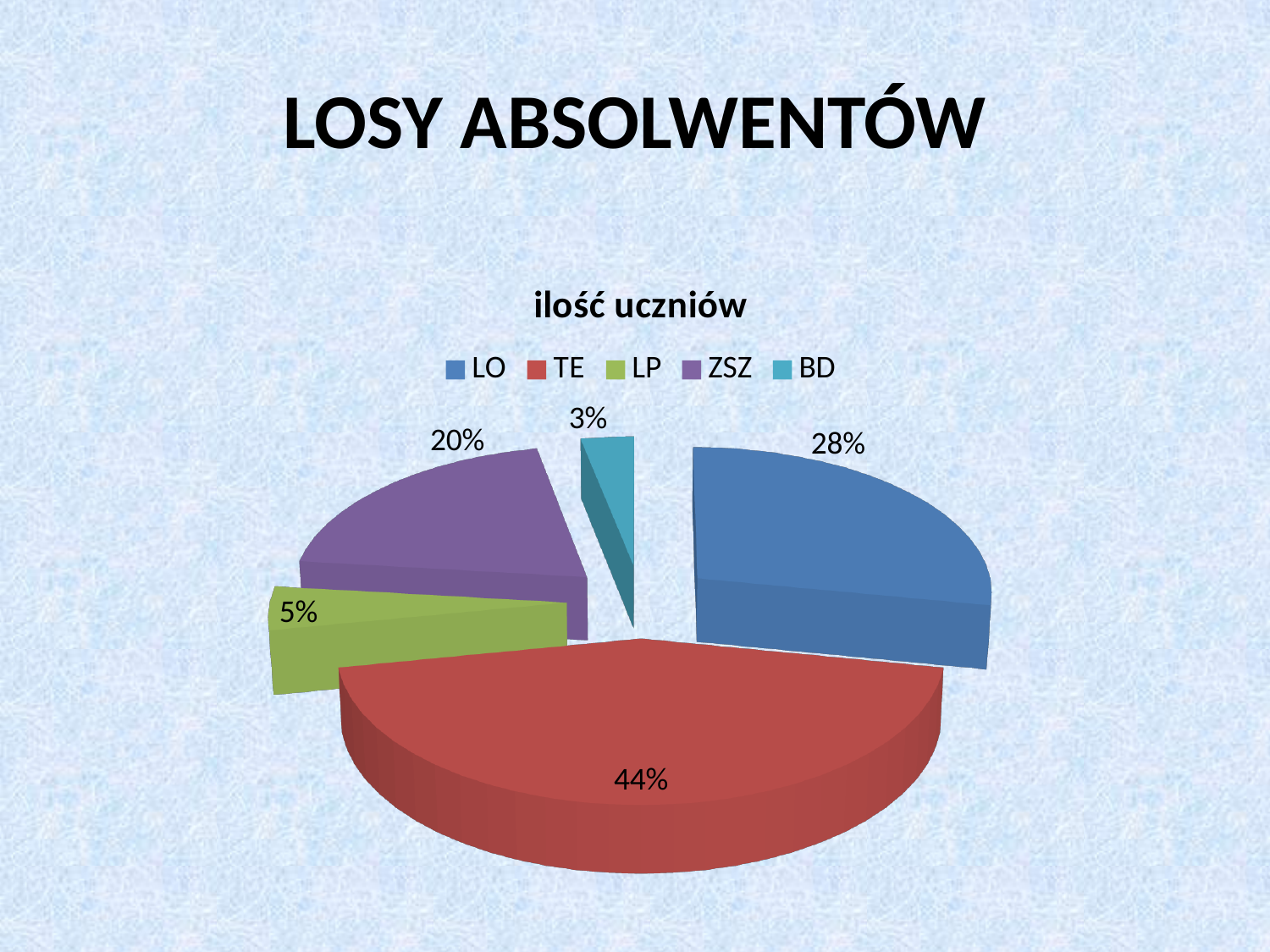
Which is larger, the share for ZSZ or the share for LP? ZSZ What share of the pie does ZSZ have? 20% What share of the pie does BD have? 3% What share of the pie does TE have? 44% Which category has the smallest slice? BD What is the title of the chart? ilość uczniów Which category has the largest slice? TE How many categories does the legend list? 5 What is the difference in percentage points between TE and LO? 16% What kind of chart is shown on the slide? pie chart